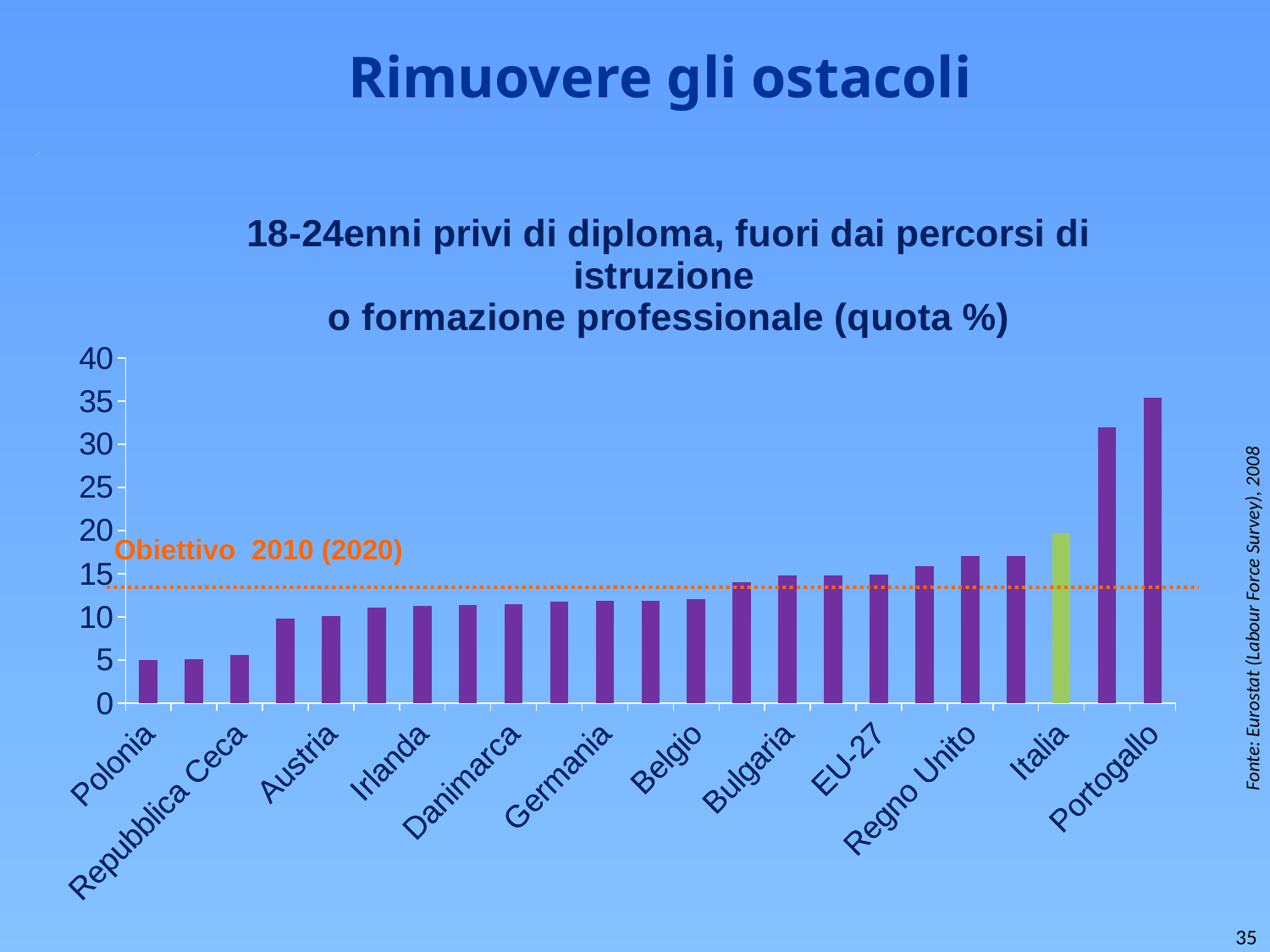
Which country has the lowest share of 18-24 year olds without a diploma? Polonia Is the value for Polonia greater or less than 10? less What kind of chart is shown on the slide? bar chart Is the value for Germania greater or less than 15? less What is the label of the dotted horizontal line on the chart? Obiettivo 2010 (2020) Do the bar values rise or fall from left to right along the x axis? rise Which is larger, the value for Polonia or the value for Belgio? Belgio Is the value for Portogallo greater or less than 30? greater Which country has the highest share of 18-24 year olds without a diploma? Portogallo Which is larger, the value for Italia or the value for Regno Unito? Italia Which country's bar is shown in a different colour (green) from the others? Italia